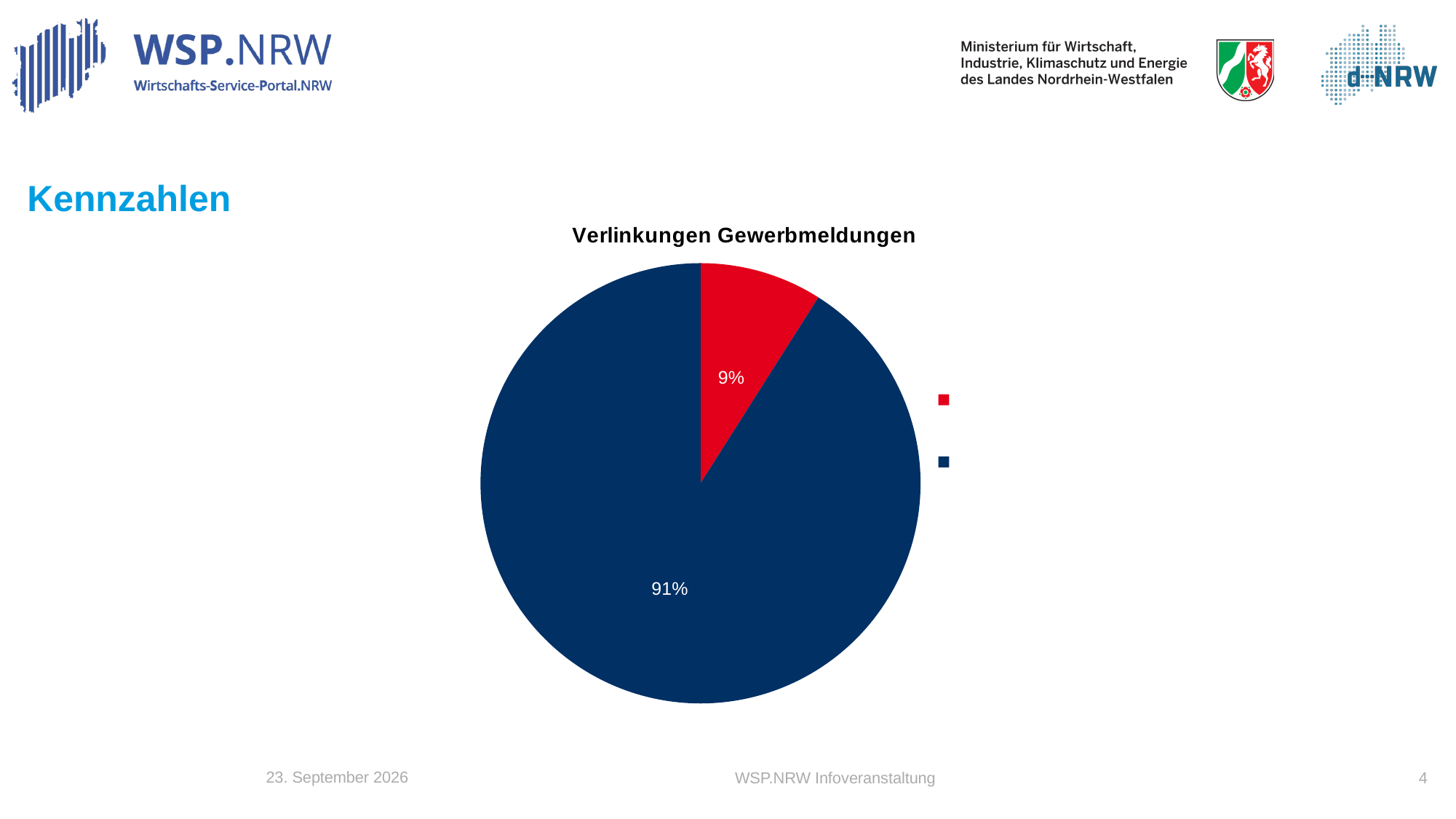
What share of the pie does the red slice represent? 9% How many slices does the pie chart have? 2 Which slice of the pie chart is the smallest? the red slice (9%) How many entries does the legend list? 2 What percentage is shown on the red slice of the pie chart? 9% What is the difference in percentage points between the dark blue slice and the red slice? 82 percentage points What kind of chart is shown on the slide? pie chart What is the title of the chart? Verlinkungen Gewerbmeldungen Which is larger, the red slice or the dark blue slice? the dark blue slice What colours are used for the two legend entries? red and dark blue Which slice of the pie chart is the largest? the dark blue slice (91%) What percentage is shown on the dark blue slice of the pie chart? 91%